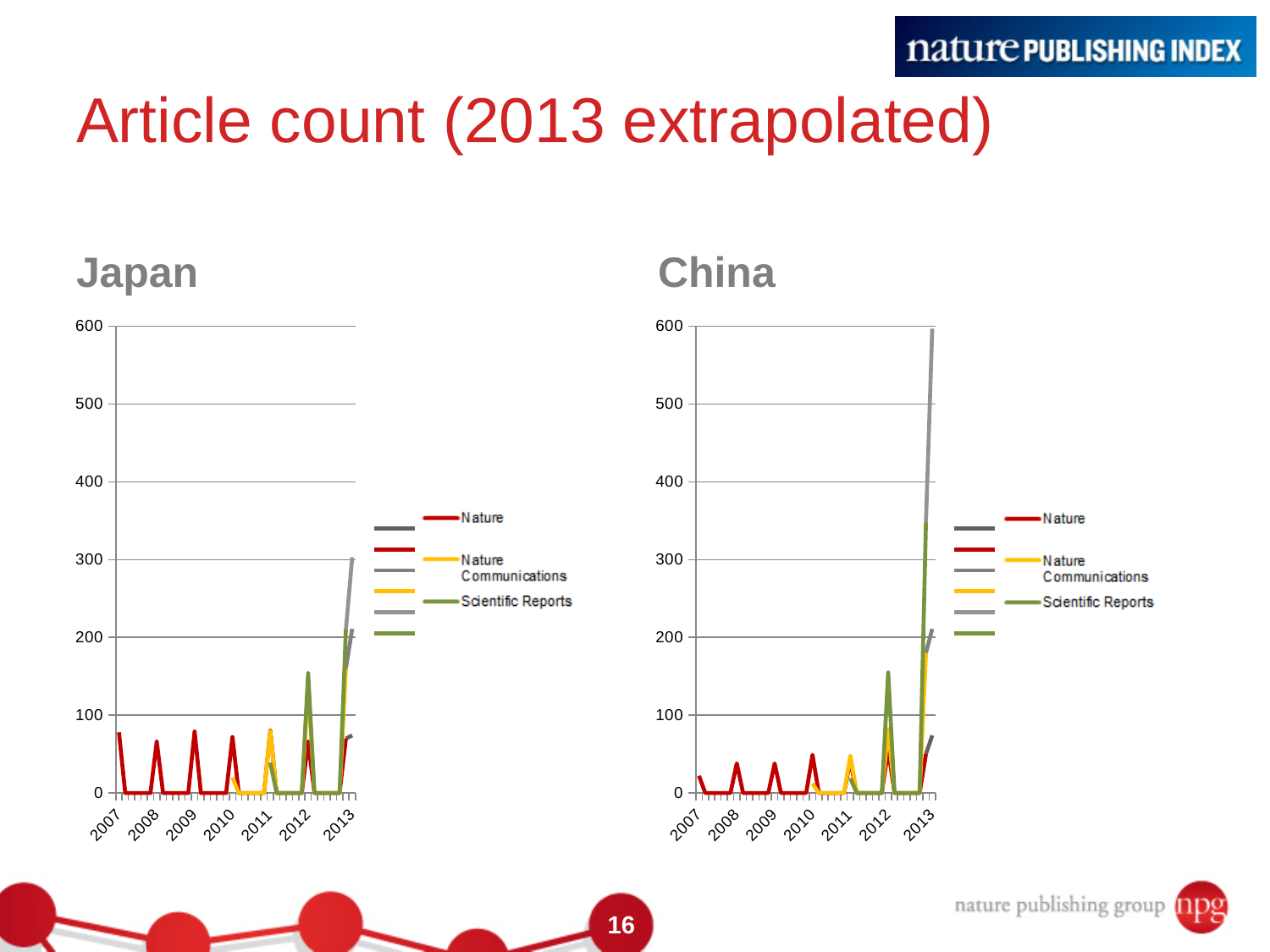
How many series does the legend of the China chart list? 3 In the Japan chart, which series reaches the highest value? Scientific Reports In the Japan chart, is the value for Scientific Reports in 2012 greater or less than 100? greater In the Japan chart, is the value for Nature in 2007 greater or less than 100? less In the China chart, is the value for Scientific Reports in 2013 greater or less than 500? greater Which is larger: the 2013 value for Scientific Reports in the China chart or in the Japan chart? China In the China chart, which series reaches the highest value? Scientific Reports How many years are labelled on the x axis of the Japan chart? 7 What kind of chart is the Japan chart? line chart What is the title of the slide containing the two charts? Article count (2013 extrapolated) In the Japan chart, does the Scientific Reports series rise or fall from 2012 to 2013? rise